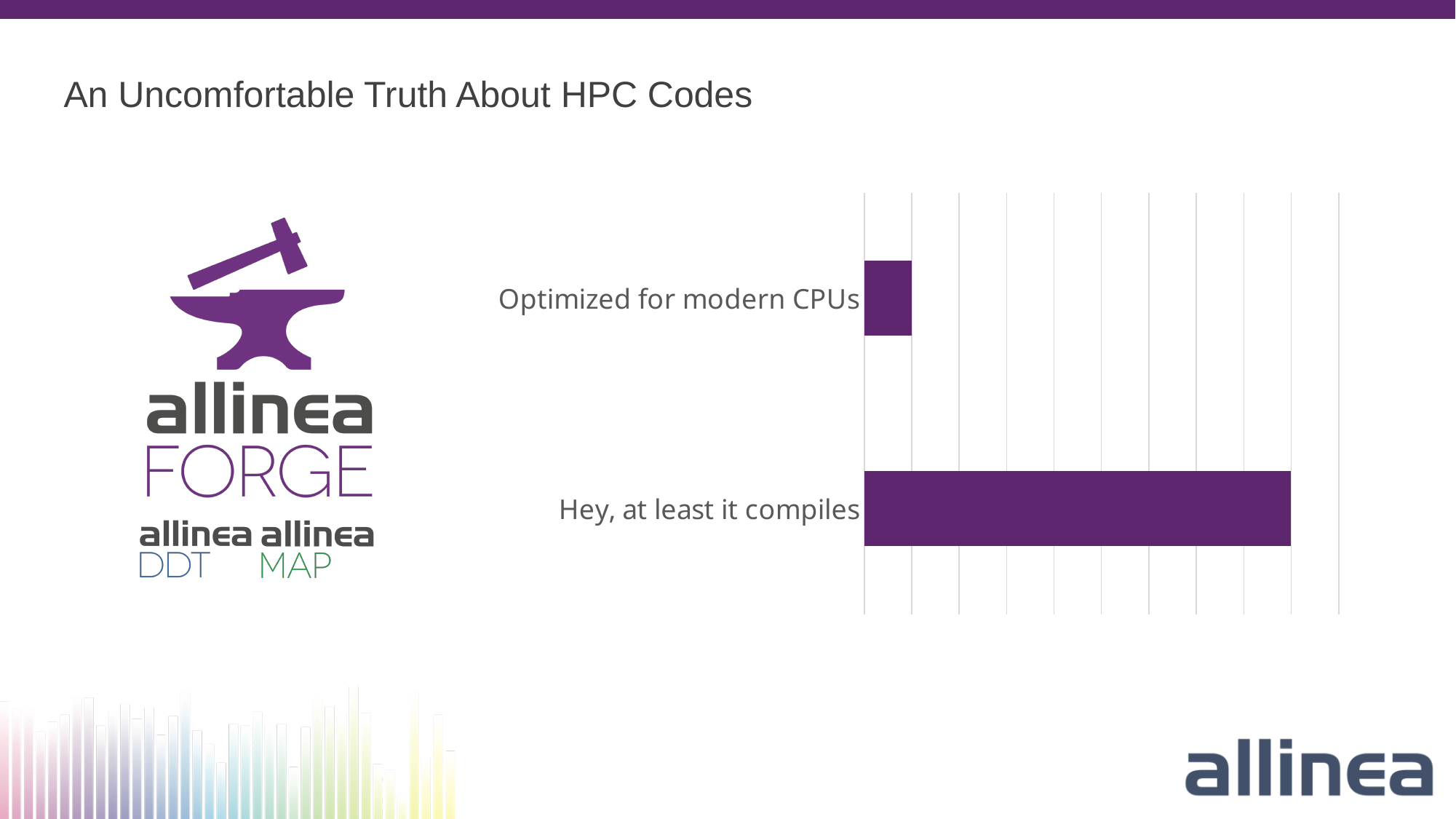
How many categories does the bar chart show? 2 Which bar is longer: "Optimized for modern CPUs" or "Hey, at least it compiles"? Hey, at least it compiles Which category has the shortest bar in the chart? Optimized for modern CPUs What kind of chart is shown on the slide? bar chart Are the bars in the chart drawn horizontally or vertically? horizontally What colour are the bars in the chart? purple Which category has the longest bar in the chart? Hey, at least it compiles